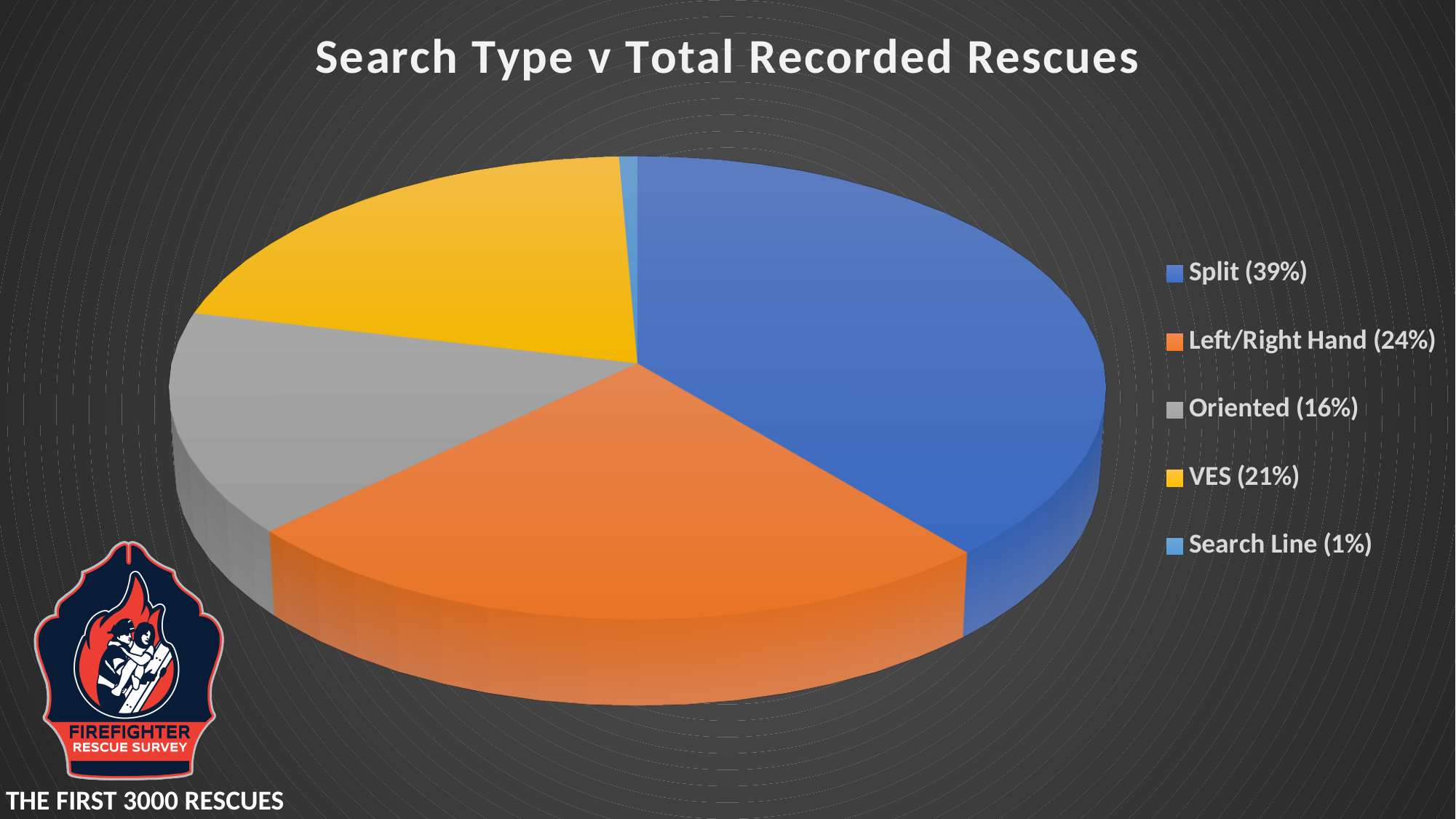
Which search type has the smallest share of recorded rescues? Search Line Which search type has the largest share of recorded rescues? Split How many search types are shown in the pie chart? 5 What is the difference in percentage points between Split and Left/Right Hand? 15 What share of total recorded rescues is attributed to Split search? 39% What percentage is shown for VES? 21% What is the title of the chart? Search Type v Total Recorded Rescues What percentage is shown for Oriented search? 16% Which colour represents the Search Line slice in the legend? Light blue What percentage is shown for Left/Right Hand search? 24% What kind of chart is shown on the slide? Pie chart Which has a larger share, VES or Oriented? VES